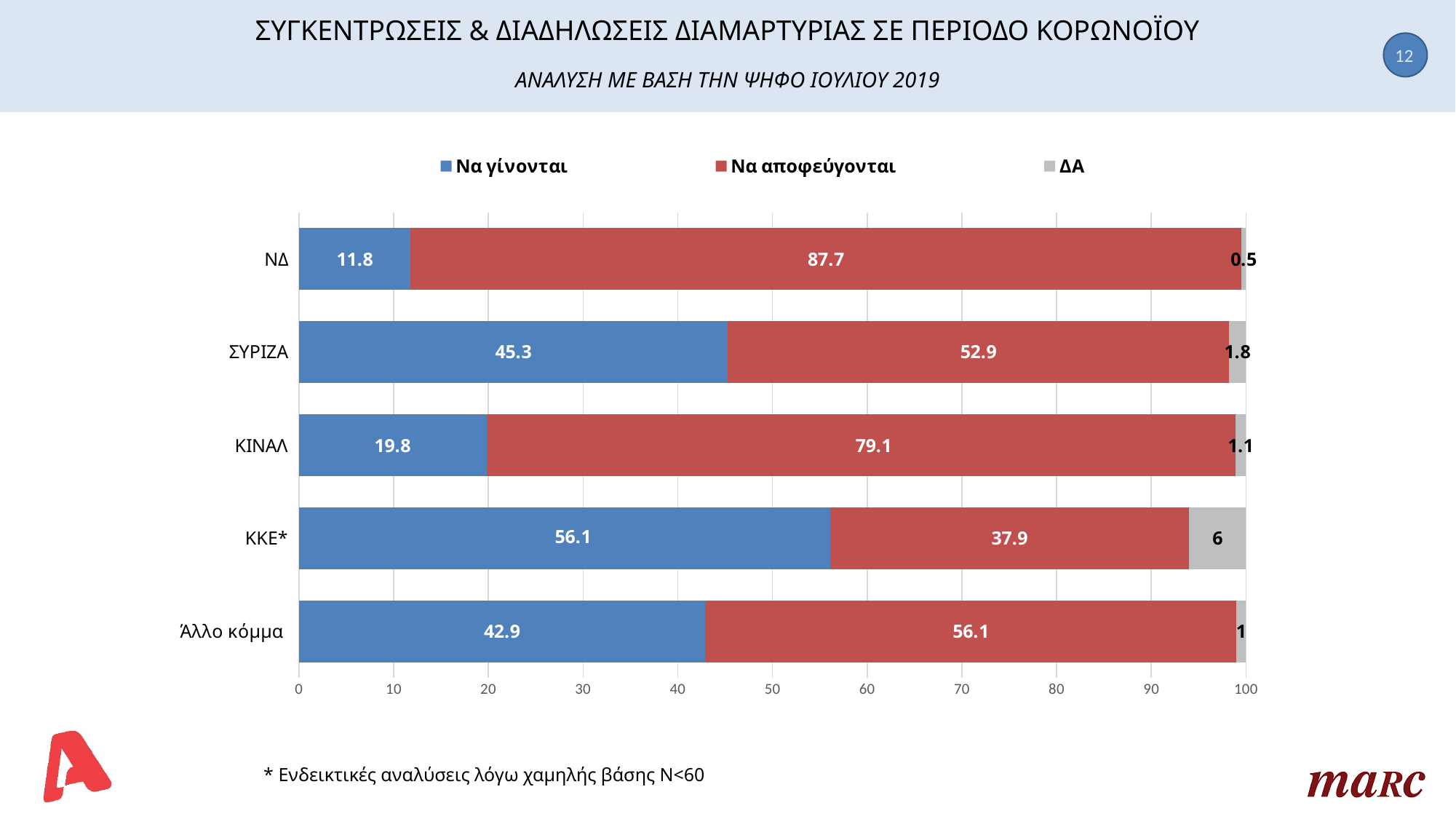
What is the value of "Να αποφεύγονται" for ΝΔ? 87.7 What kind of chart is shown on the slide? Stacked bar chart What is the total of the stacked bar for ΚΚΕ*? 100 How many categories are shown on the chart? 5 Which category has the lowest value for "Να αποφεύγονται"? ΚΚΕ* Is the "Να γίνονται" value for ΚΙΝΑΛ greater or less than 20? less Which category has the highest value for "Να γίνονται"? ΚΚΕ* Which is larger: the "Να γίνονται" value for ΣΥΡΙΖΑ or for Άλλο κόμμα? ΣΥΡΙΖΑ What is the value of "ΔΑ" for ΚΚΕ*? 6 How many series does the legend list? 3 What is the value of "Να γίνονται" for ΣΥΡΙΖΑ? 45.3 What is the difference between the "Να αποφεύγονται" values for ΝΔ and ΚΙΝΑΛ? 8.6